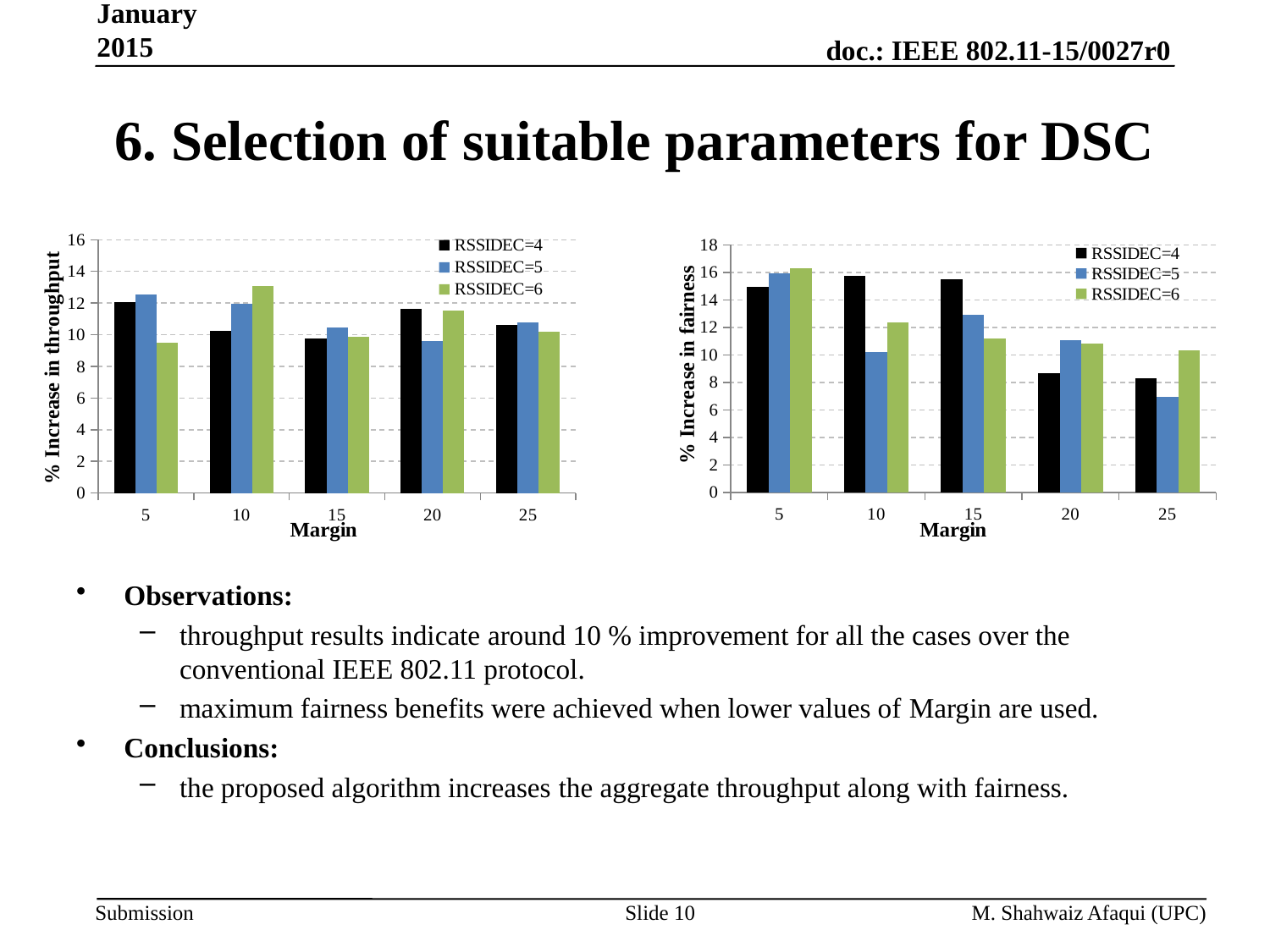
What kind of chart is the left chart (% Increase in throughput)? bar chart In the left chart (% Increase in throughput), is the value for RSSIDEC=6 at Margin 5 greater or less than 10? less How many series does the legend of the left chart (% Increase in throughput) list? 3 In the right chart (% Increase in fairness), do the RSSIDEC=4 values rise or fall from Margin 15 to Margin 25? fall What is the y-axis label of the right chart? % Increase in fairness In the right chart (% Increase in fairness), which series has the highest bar at Margin 15? RSSIDEC=4 In the right chart (% Increase in fairness), which is larger at Margin 10: RSSIDEC=4 or RSSIDEC=5? RSSIDEC=4 How many Margin categories are shown on the x axis of the left chart (% Increase in throughput)? 5 In the left chart (% Increase in throughput), is the value for RSSIDEC=6 at Margin 10 greater or less than 12? greater In the right chart (% Increase in fairness), is the value for RSSIDEC=4 at Margin 25 greater or less than 10? less In the right chart (% Increase in fairness), at which Margin is the RSSIDEC=5 bar lowest? 25 In the left chart (% Increase in throughput), at which Margin is the RSSIDEC=6 bar highest? 10